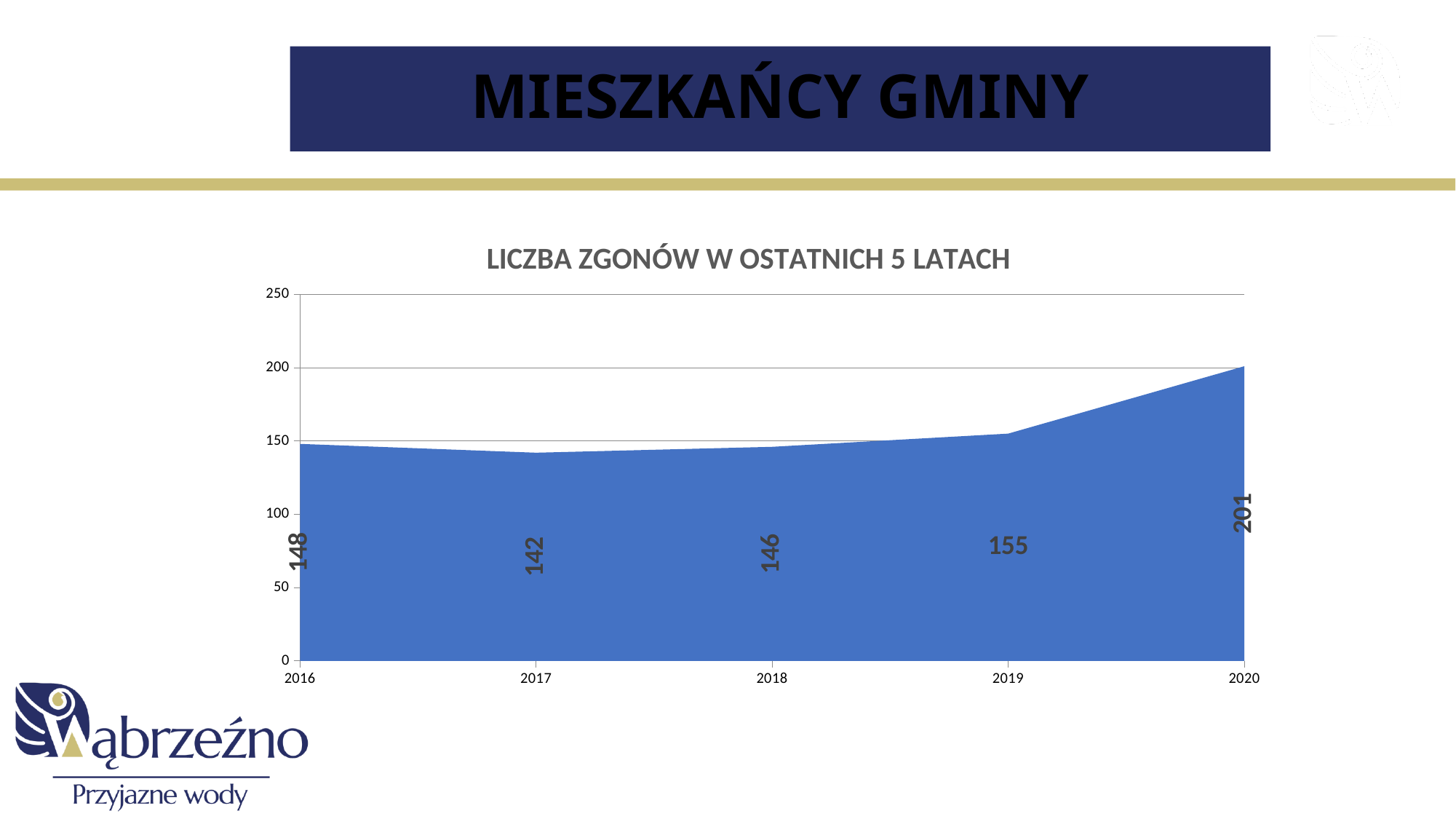
What is the number of deaths shown for 2019? 155 Which year has more deaths, 2018 or 2019? 2019 How many years are shown on the x axis of the chart? 5 What is the number of deaths shown for 2020? 201 What is the number of deaths shown for 2016? 148 Which year has the highest number of deaths? 2020 Is the value for 2020 greater or less than 200? greater What is the difference between the number of deaths in 2020 and in 2019? 46 What is the number of deaths shown for 2017? 142 What is the difference between the number of deaths in 2016 and in 2017? 6 Which year has the lowest number of deaths? 2017 What is the title of the chart? LICZBA ZGONÓW W OSTATNICH 5 LATACH